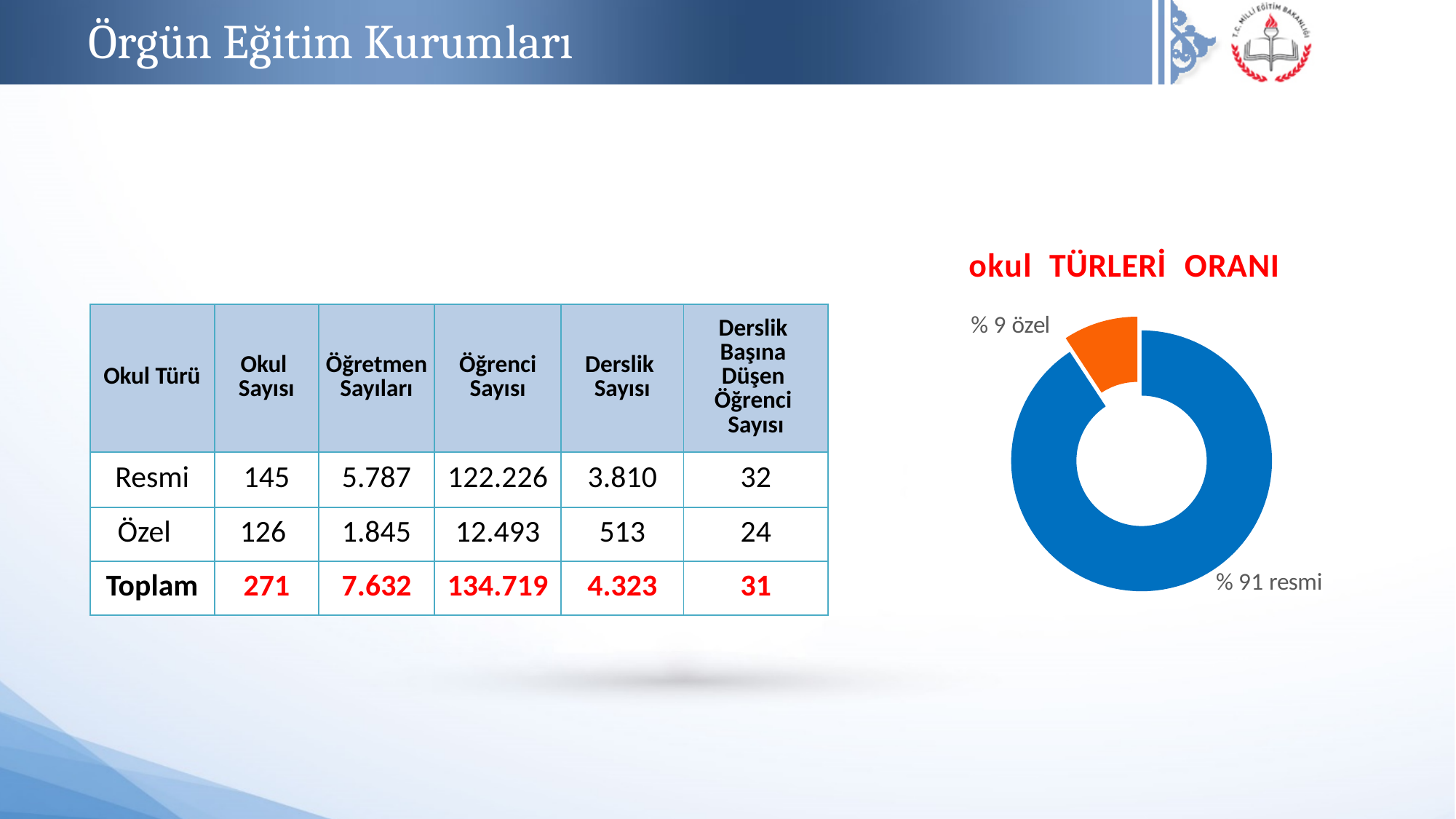
In the okul TÜRLERİ ORANI chart, what colour is the özel slice? Orange What type of chart is shown on the right of the slide? Doughnut (pie) chart In the okul TÜRLERİ ORANI chart, what share is labelled for resmi? % 91 In the okul TÜRLERİ ORANI chart, is the share for resmi greater or less than 50%? greater What is the title of the chart on the slide? okul TÜRLERİ ORANI In the okul TÜRLERİ ORANI chart, which slice is the smallest? özel In the okul TÜRLERİ ORANI chart, by how many percentage points does the resmi share exceed the özel share? 82 percentage points How many slices does the okul TÜRLERİ ORANI chart have? 2 In the okul TÜRLERİ ORANI chart, which slice is the largest? resmi In the okul TÜRLERİ ORANI chart, what share is labelled for özel? % 9 In the okul TÜRLERİ ORANI chart, which is larger, the resmi slice or the özel slice? resmi